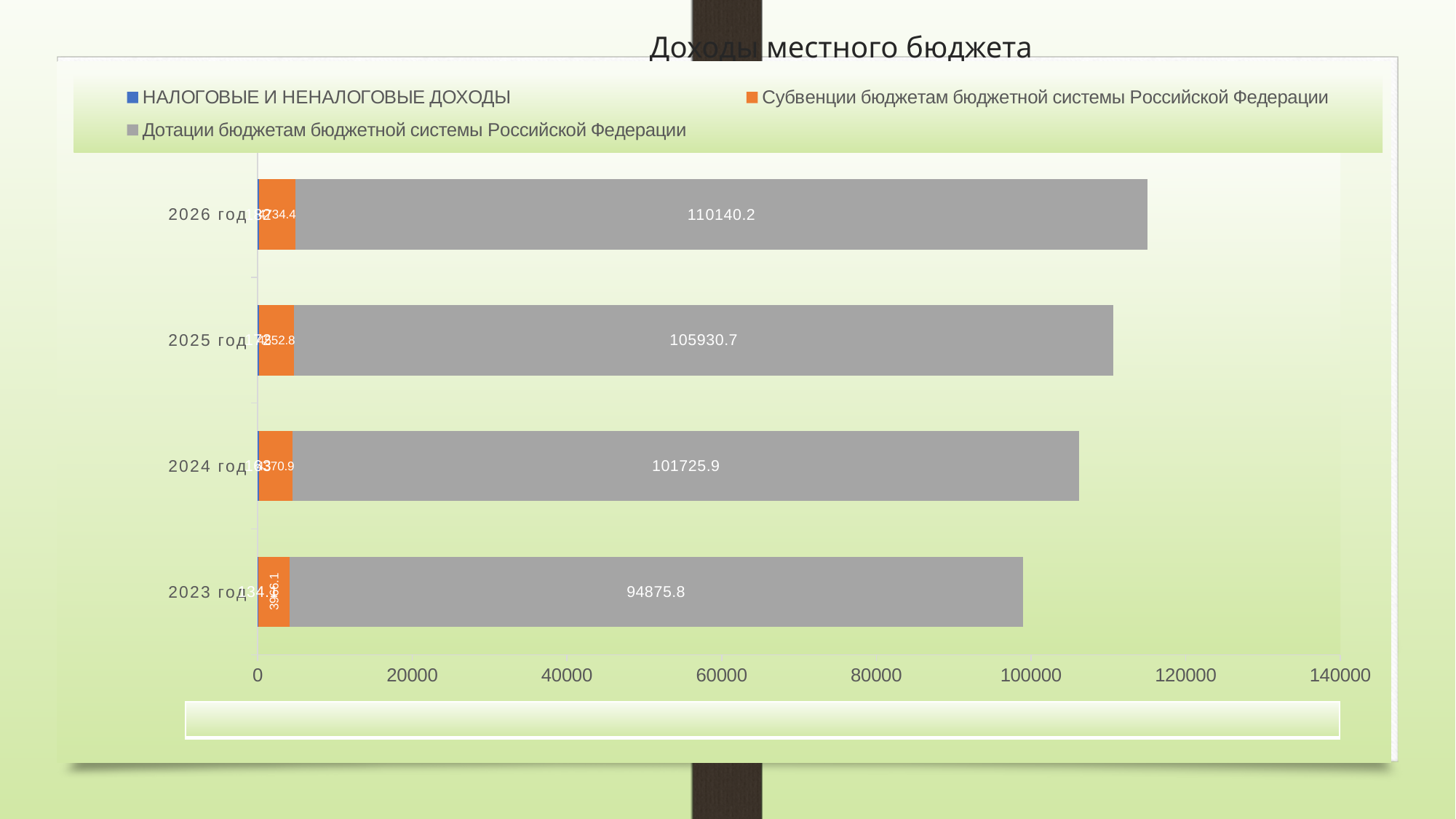
Is the total length of the stacked bar for 2026 год greater or less than 100000? greater How many year categories are plotted on the chart? 4 What is the value of Дотации бюджетам бюджетной системы Российской Федерации for 2023 год? 94875.8 Which year has the larger Дотации value, 2024 год or 2025 год? 2025 год Which year has the lowest value for Дотации бюджетам бюджетной системы Российской Федерации? 2023 год What is the value of Дотации бюджетам бюджетной системы Российской Федерации for 2026 год? 110140.2 What kind of chart is shown on the slide? bar chart What is the difference between the Дотации values for 2026 год and 2023 год? 15264.4 How many series does the legend list? 3 Do the Дотации values rise or fall from 2023 год to 2026 год? rise What is the title of the chart? Доходы местного бюджета Which year has the highest value for Дотации бюджетам бюджетной системы Российской Федерации? 2026 год